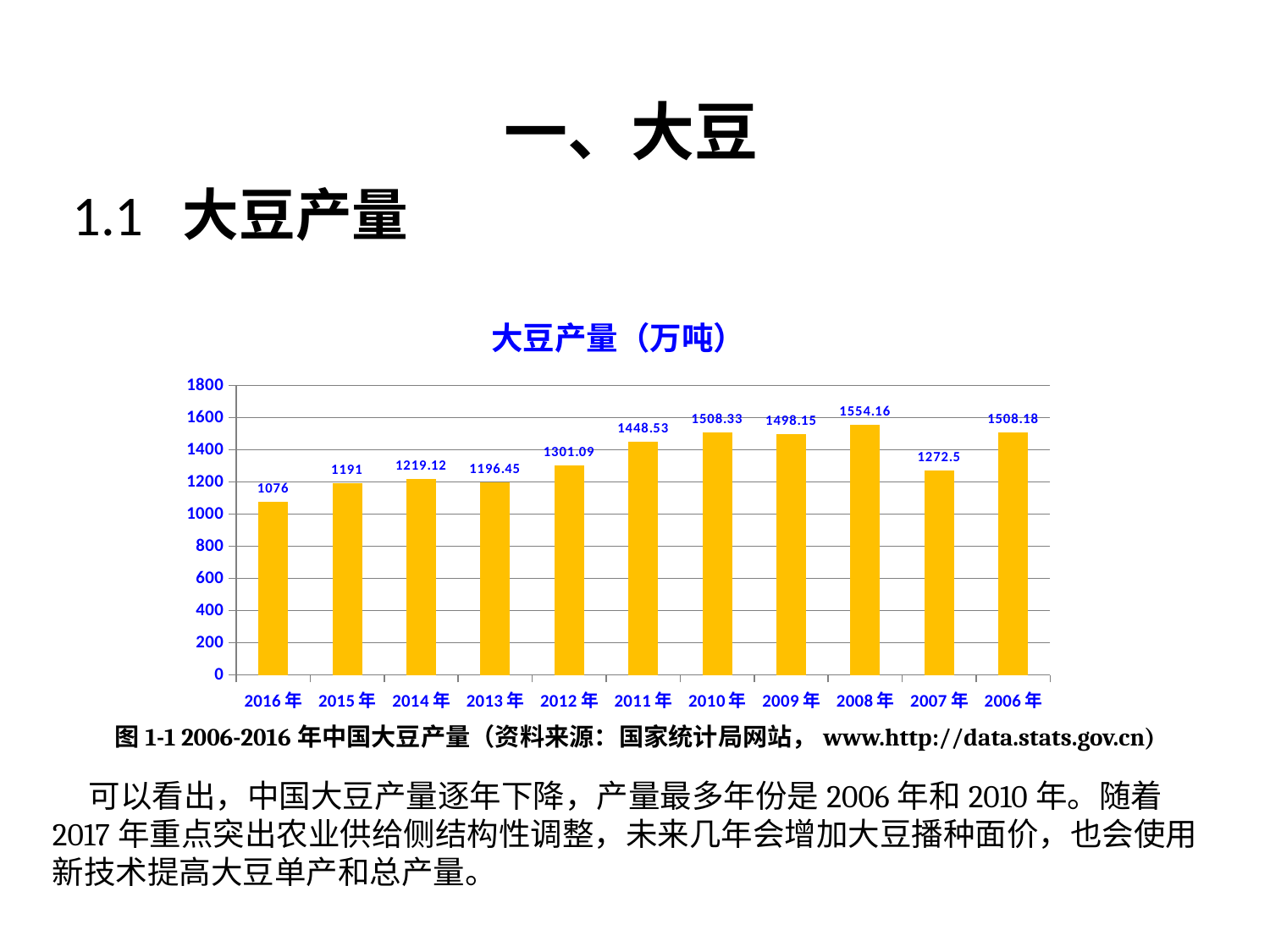
Which year has the lowest soybean output in the chart? 2016年 Is the value for 2016年 greater or less than 1200? less What is the soybean output value shown for 2016年? 1076 How many years (bars) are shown in the chart? 11 What is the title of the chart? 大豆产量（万吨） Which year has the highest soybean output in the chart? 2008年 What is the value shown for 2007年? 1272.5 Which is larger, the value for 2011年 or the value for 2012年? 2011年 What is the value shown for 2012年? 1301.09 What type of chart is shown on the slide? Bar chart What is the value shown for 2008年? 1554.16 What is the difference between the values for 2008年 and 2016年? 478.16